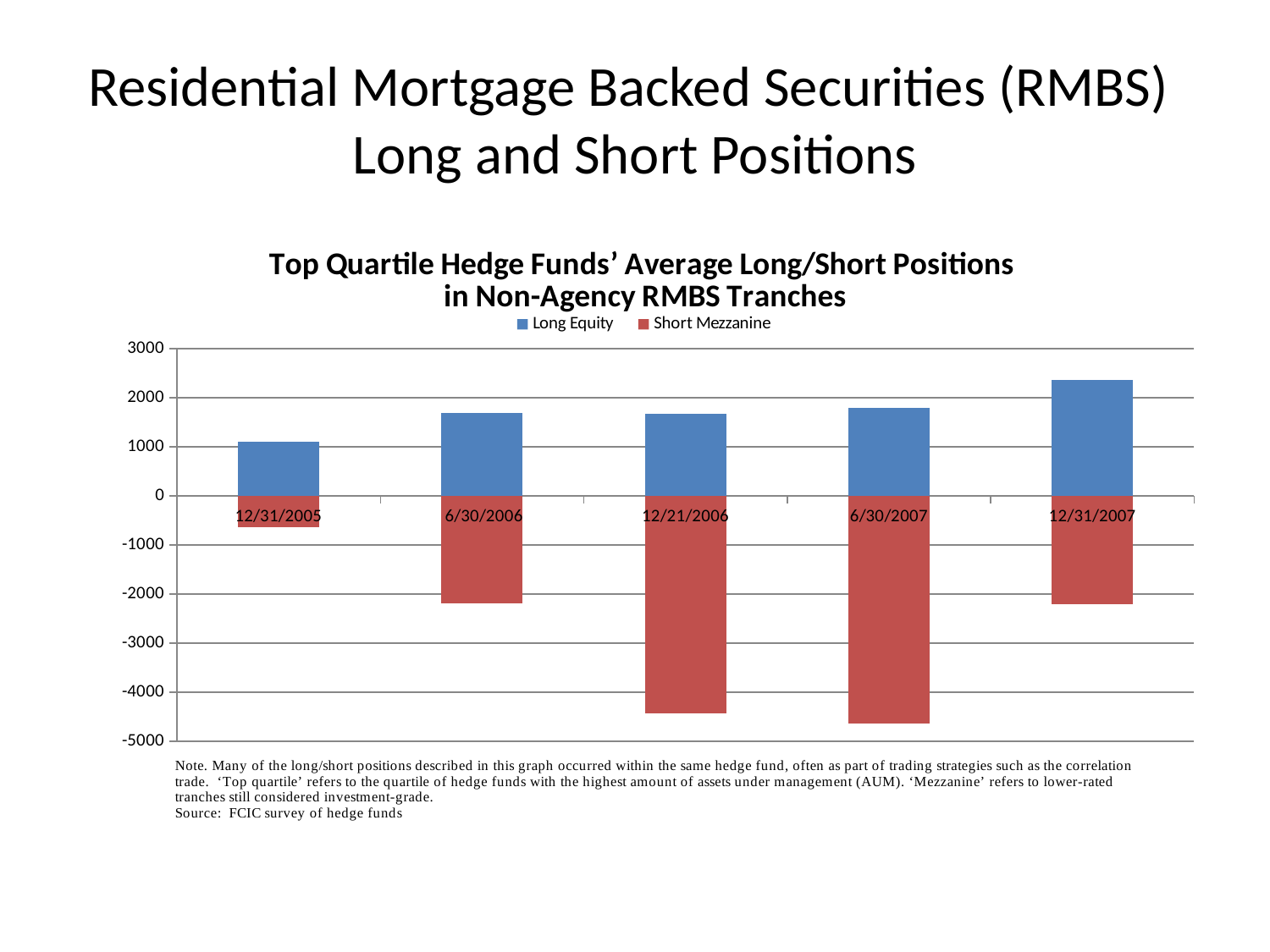
Which series is shown in blue? Long Equity Is the Long Equity value for 12/31/2005 greater or less than 1000? greater How many series does the legend list? 2 How many dates are shown on the x axis? 5 Is the Short Mezzanine value for 12/21/2006 greater or less than -4000? less Which is larger, the Long Equity value for 6/30/2006 or for 12/31/2005? 6/30/2006 On which date is the Long Equity position lowest? 12/31/2005 On which date is the Short Mezzanine position smallest in magnitude (closest to zero)? 12/31/2005 On which date is the Long Equity position highest? 12/31/2007 What is the title of the chart? Top Quartile Hedge Funds' Average Long/Short Positions in Non-Agency RMBS Tranches Is the Long Equity value for 12/31/2007 greater or less than 2000? greater What kind of chart is shown on the slide? bar chart